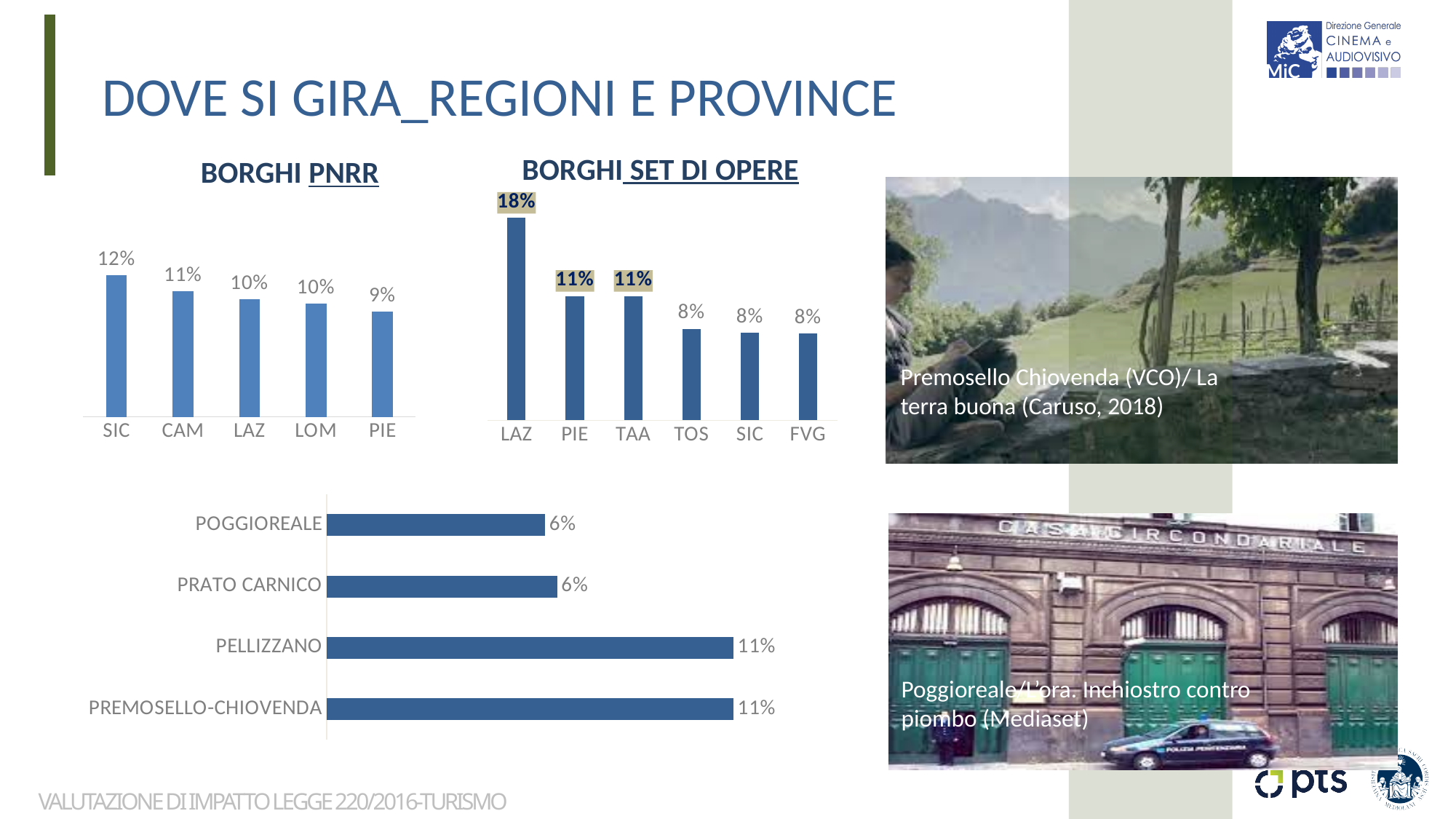
In the BORGHI SET DI OPERE chart, which is larger, the value for PIE or the value for FVG? PIE In the BORGHI PNRR chart, what is the value for SIC? 12% In the BORGHI PNRR chart, which category has the lowest value? PIE In the horizontal bar chart at the bottom left, what is the value for PELLIZZANO? 11% In the BORGHI SET DI OPERE chart, what is the difference between the values for LAZ and TOS? 10% In the BORGHI PNRR chart, what is the difference between the values for SIC and PIE? 3% In the BORGHI SET DI OPERE chart, how many categories are shown? 6 What kind of chart is the one at the bottom left of the slide? Bar chart In the BORGHI SET DI OPERE chart, what is the value for LAZ? 18% In the BORGHI SET DI OPERE chart, which category has the highest value? LAZ In the BORGHI PNRR chart, how many categories are shown? 5 In the horizontal bar chart at the bottom left, what is the value for PRATO CARNICO? 6%